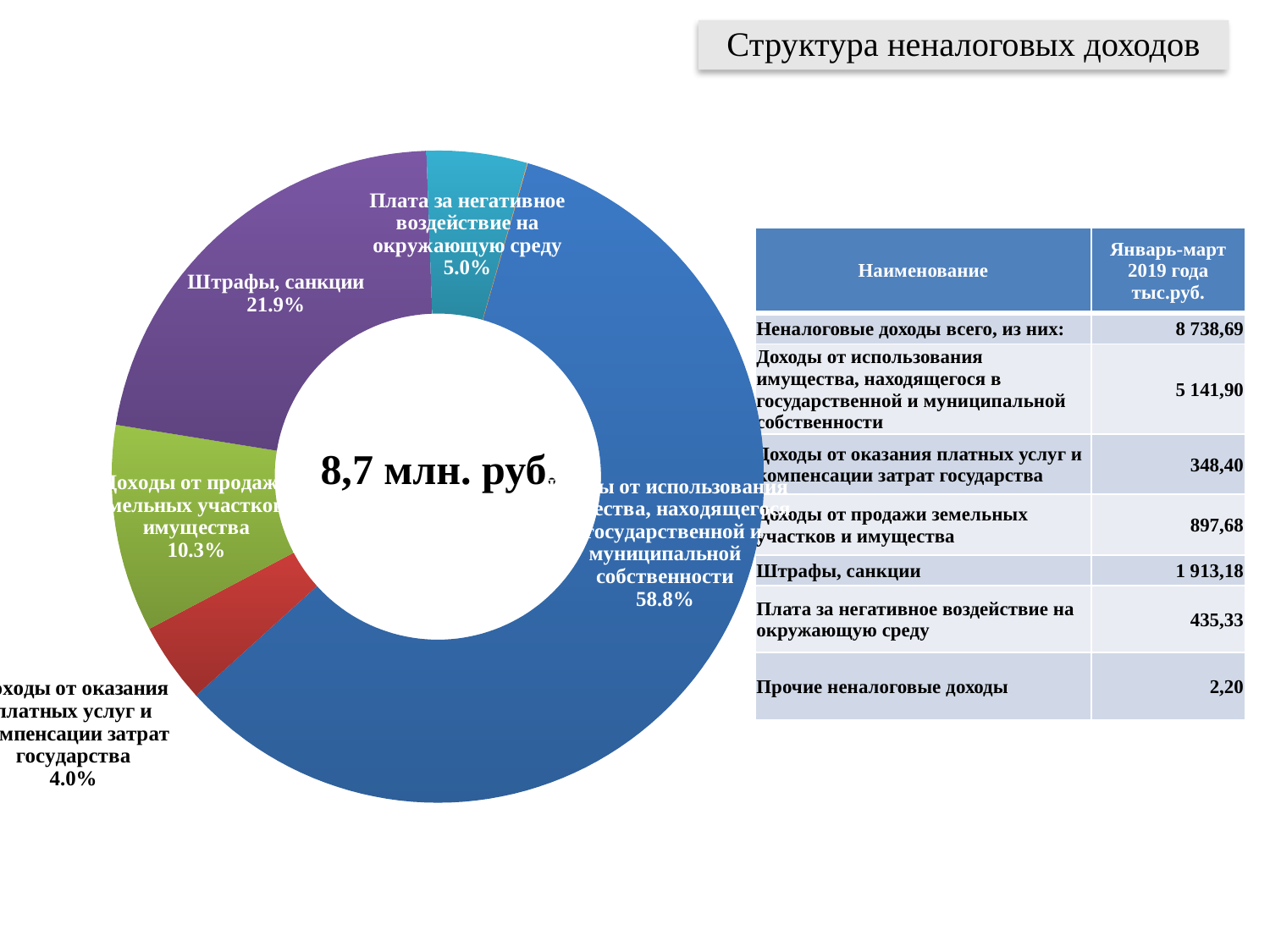
What share of the pie chart does "Доходы от продажи земельных участков и имущества" represent? 10.3% What share of the pie chart does "Плата за негативное воздействие на окружающую среду" represent? 5.0% What is the difference in percentage points between the "Штрафы, санкции" slice and the "Доходы от продажи земельных участков и имущества" slice? 11.6 What share of the pie chart does "Штрафы, санкции" represent? 21.9% Which category has the smallest slice in the pie chart? Доходы от оказания платных услуг и компенсации затрат государства What kind of chart is shown on the slide? Pie (donut) chart What total value is printed in the centre of the donut chart? 8,7 млн. руб. Which slice is larger: "Штрафы, санкции" or "Плата за негативное воздействие на окружающую среду"? Штрафы, санкции Which category has the largest slice in the pie chart? Доходы от использования имущества, находящегося в государственной и муниципальной собственности How many slices does the pie chart have? 5